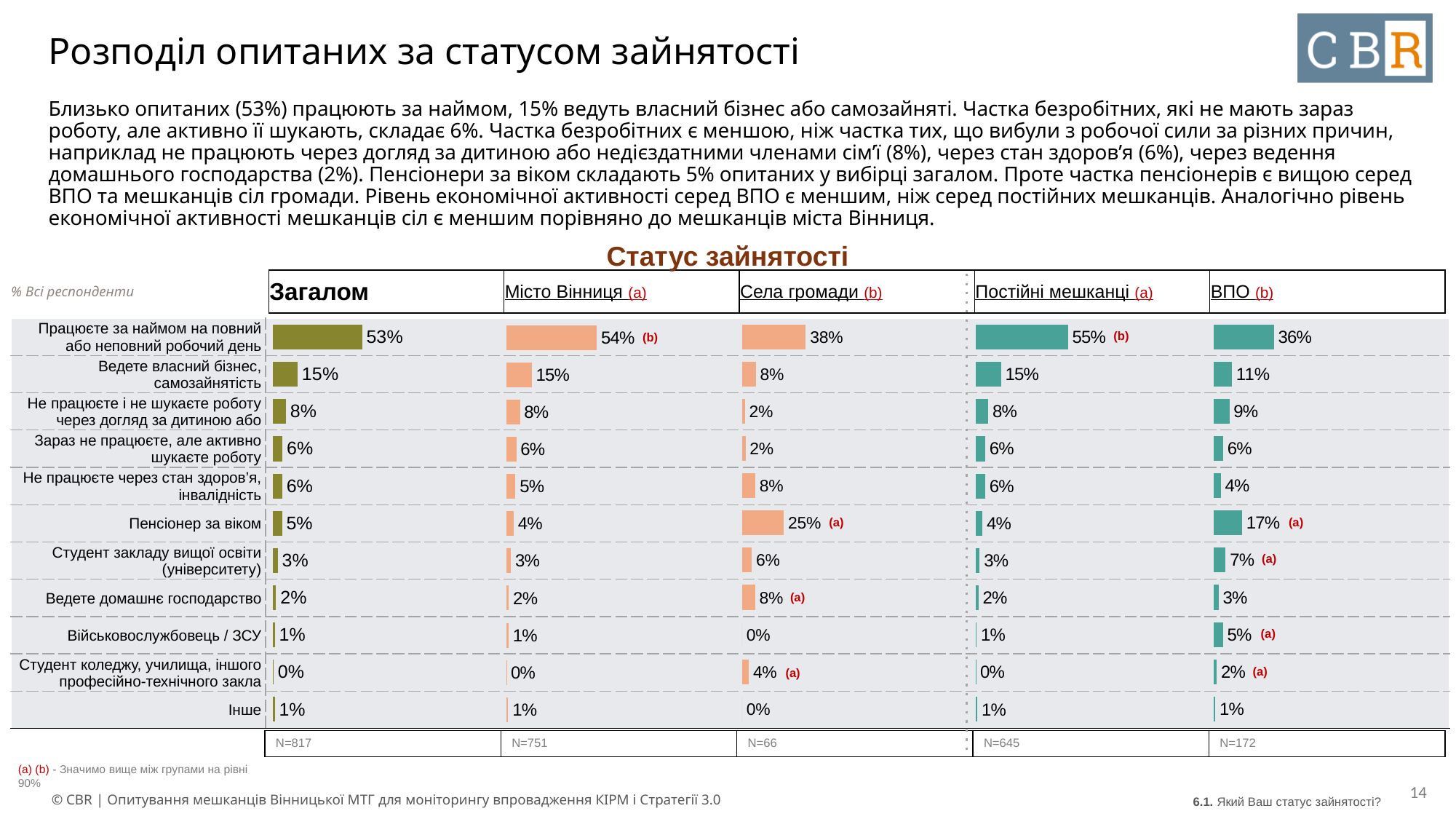
What type of chart is used on the slide to show 'Статус зайнятості'? Bar chart In the 'Статус зайнятості' chart, which is larger for 'Пенсіонер за віком': 'Місто Вінниця' or 'Села громади'? Села громади How many employment status categories are listed in the 'Статус зайнятості' chart? 11 In the 'Статус зайнятості' chart, what is the difference between 'Села громади' and 'Місто Вінниця' for 'Ведете домашнє господарство'? 6 percentage points In the 'Статус зайнятості' chart, which category has the lowest value in the 'Загалом' column? Студент коледжу, училища, іншого професійно-технічного закла What is the sample size (N) shown for the 'ВПО' column in the 'Статус зайнятості' chart? N=172 In the 'Статус зайнятості' chart, what is the difference between 'Постійні мешканці' and 'ВПО' for 'Працюєте за наймом на повний або неповний робочий день'? 19 percentage points In the 'Статус зайнятості' chart, which category has the highest value in the 'Загалом' column? Працюєте за наймом на повний або неповний робочий день How many respondent groups (columns) are shown in the 'Статус зайнятості' chart? 5 In the 'Статус зайнятості' chart, what is the value for 'Військовослужбовець / ЗСУ' in the 'ВПО' column? 5% In the 'Статус зайнятості' chart, what is the value for 'Пенсіонер за віком' in the 'Села громади' column? 25% In the 'Статус зайнятості' chart, what share of all respondents (Загалом) work for hire full- or part-time ('Працюєте за наймом на повний або неповний робочий день')? 53%